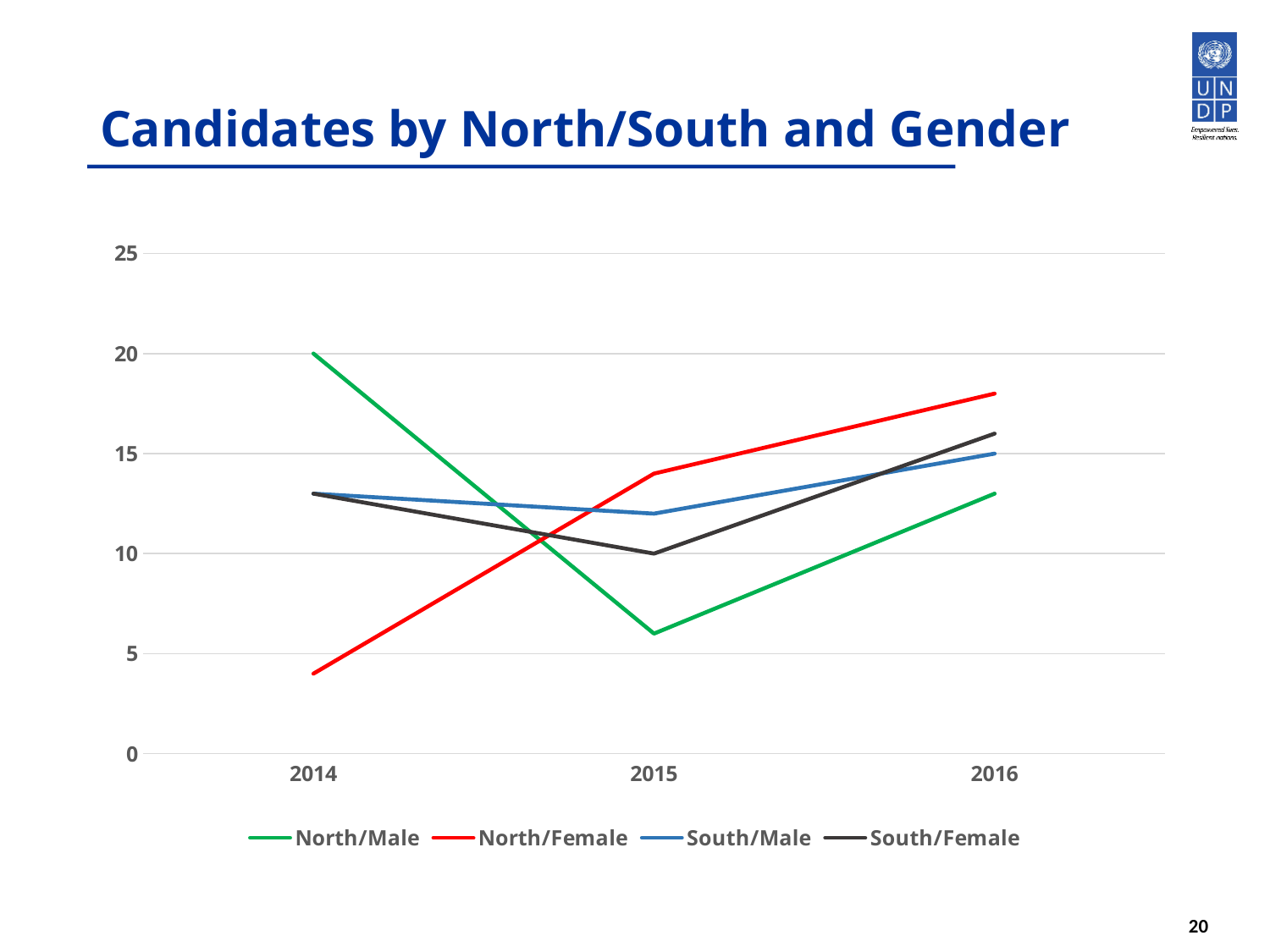
What kind of chart is shown on the slide? line chart What is the title of the chart? Candidates by North/South and Gender Is the value for North/Female in 2014 greater or less than 5? less Which series has the lowest value in 2014? North/Female Which series has the lowest value in 2015? North/Male Which series has the highest value in 2016? North/Female Is the value for North/Female in 2016 greater or less than 15? greater What is the value for South/Female in 2015? 10 How many years are shown on the x axis? 3 How many series does the legend list? 4 What is the value for North/Male in 2014? 20 Does the North/Female line rise or fall from 2014 to 2016? rise